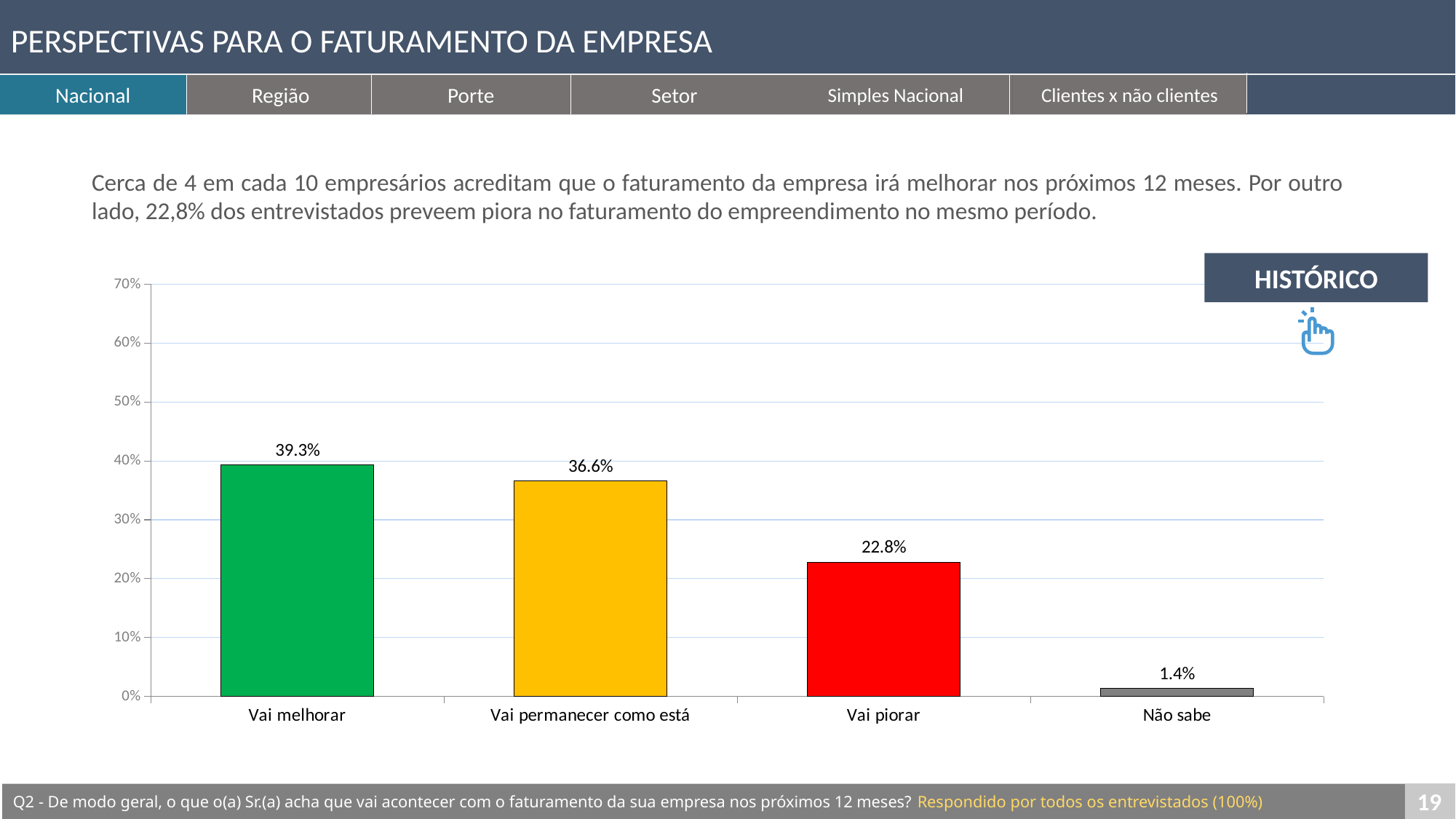
What is the value for "Vai permanecer como está"? 36.6% What is the difference between "Vai melhorar" and "Vai piorar"? 16.5% What kind of chart is shown on the slide? bar chart Is the value for "Vai piorar" greater or less than 30%? less What is the value for "Vai melhorar"? 39.3% Which category has the lowest value? Não sabe Which is larger, "Vai permanecer como está" or "Vai piorar"? Vai permanecer como está What colour is the bar for "Vai piorar"? red How many categories are shown on the x axis? 4 What is the value for "Não sabe"? 1.4% Which category has the highest value? Vai melhorar What is the value for "Vai piorar"? 22.8%